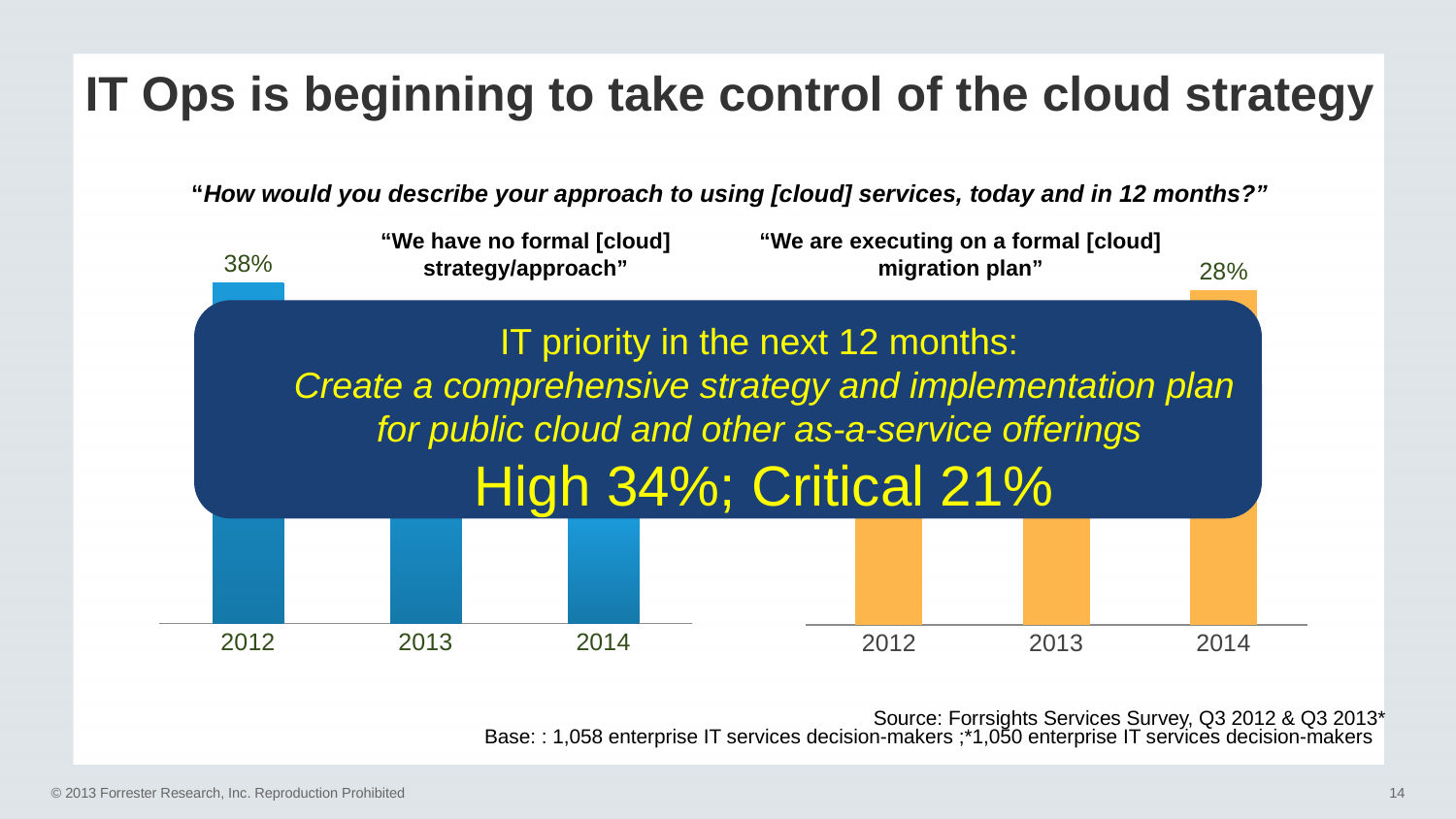
Which is larger: the 2012 value in the left chart or the 2014 value in the right chart? The 2012 value in the left chart (38%) How many years are shown on the x axis of the right chart? 3 In the left chart ("We have no formal [cloud] strategy/approach"), what is the value for 2012? 38% Which years appear on the x axis of the right chart? 2012, 2013, 2014 What is the difference between the 2012 value in the left chart (38%) and the 2014 value in the right chart (28%)? 10 percentage points In the right chart ("We are executing on a formal [cloud] migration plan"), what is the value for 2014? 28% What kind of chart is used on this slide? Bar chart What is the title of the left chart? "We have no formal [cloud] strategy/approach" How many years are shown on the x axis of the left chart? 3 What colour are the bars in the right chart ("We are executing on a formal [cloud] migration plan")? Orange